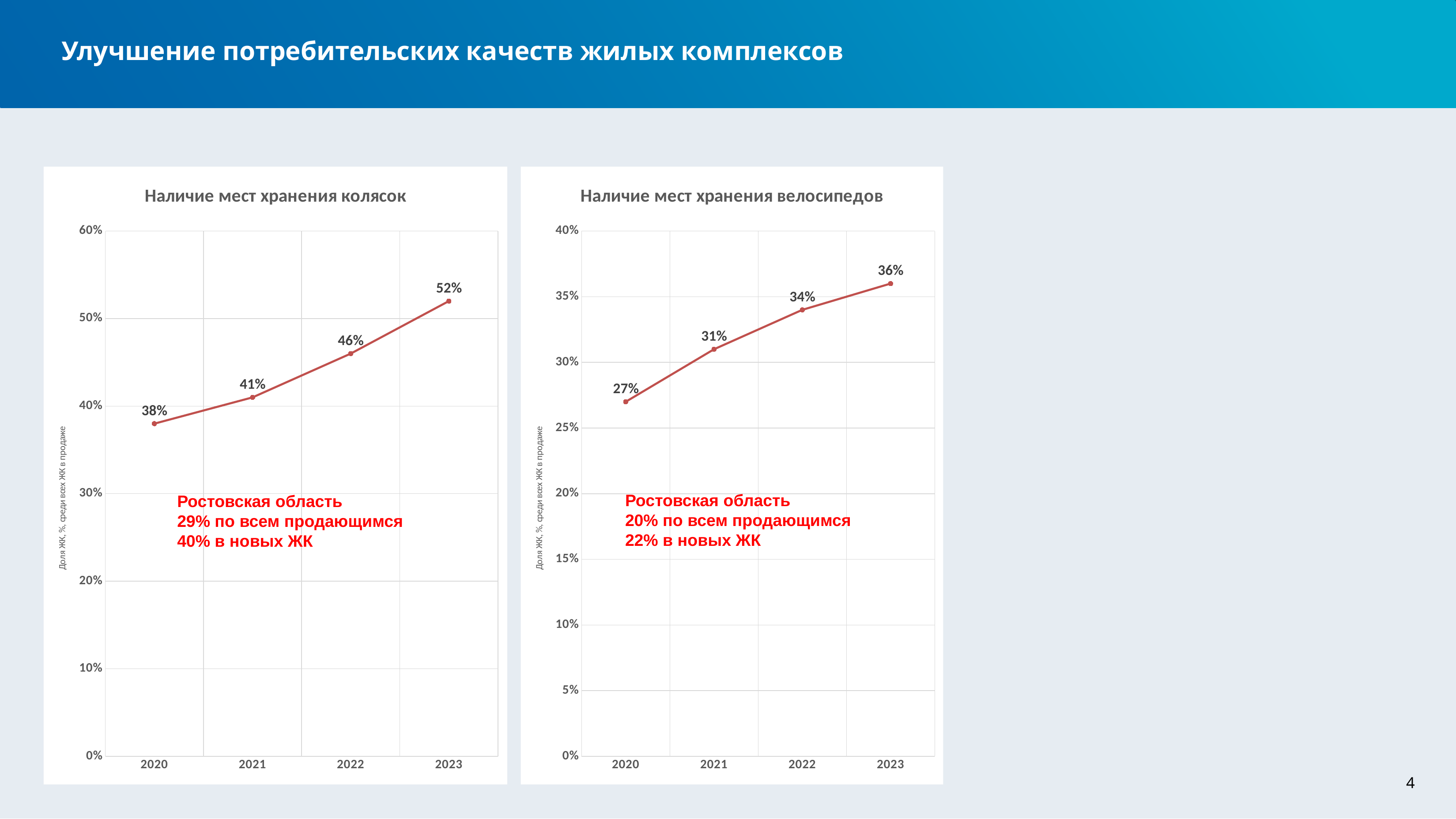
In the chart titled "Наличие мест хранения колясок", what is the value for 2023? 52% In the chart titled "Наличие мест хранения колясок", what is the value for 2020? 38% In the chart titled "Наличие мест хранения велосипедов", what is the difference between the 2022 and 2021 values? 3% How many data points are plotted in the chart titled "Наличие мест хранения велосипедов"? 4 What kind of chart is the chart titled "Наличие мест хранения колясок"? line chart In the chart titled "Наличие мест хранения колясок", which year has the highest value? 2023 In the chart titled "Наличие мест хранения велосипедов", what is the value for 2021? 31% In the chart titled "Наличие мест хранения колясок", is the value for 2022 greater or less than 50%? less In the chart titled "Наличие мест хранения велосипедов", do the values rise or fall from 2020 to 2023? rise In the chart titled "Наличие мест хранения велосипедов", what is the value for 2023? 36% In the chart titled "Наличие мест хранения велосипедов", which year has the lowest value? 2020 In the chart titled "Наличие мест хранения колясок", what is the difference between the 2023 and 2020 values? 14%